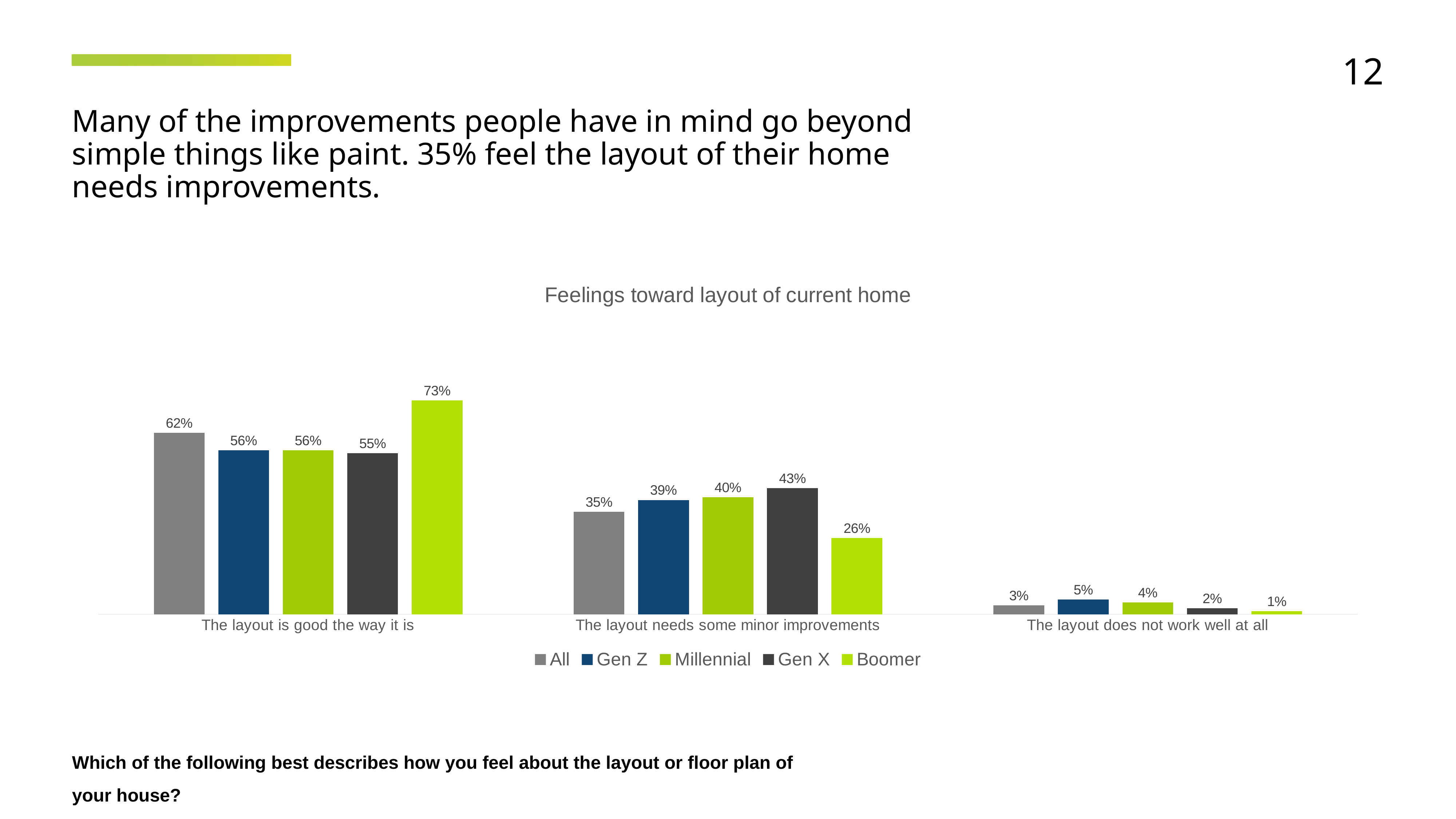
What is the difference between the Gen Z and Boomer values in the category 'The layout does not work well at all'? 4% What is the value for All in the category 'The layout does not work well at all'? 3% How many series does the legend list? 5 How many categories are shown on the x axis? 3 Which series has the highest value in the category 'The layout is good the way it is'? Boomer Which is larger in the category 'The layout needs some minor improvements': Gen Z or Millennial? Millennial What is the difference between the Boomer and All values in the category 'The layout is good the way it is'? 11% What is the value for Boomer in the category 'The layout is good the way it is'? 73% What is the title of the chart? Feelings toward layout of current home Which series has the lowest value in the category 'The layout needs some minor improvements'? Boomer What kind of chart is shown on the slide? Bar chart What is the value for Gen X in the category 'The layout needs some minor improvements'? 43%